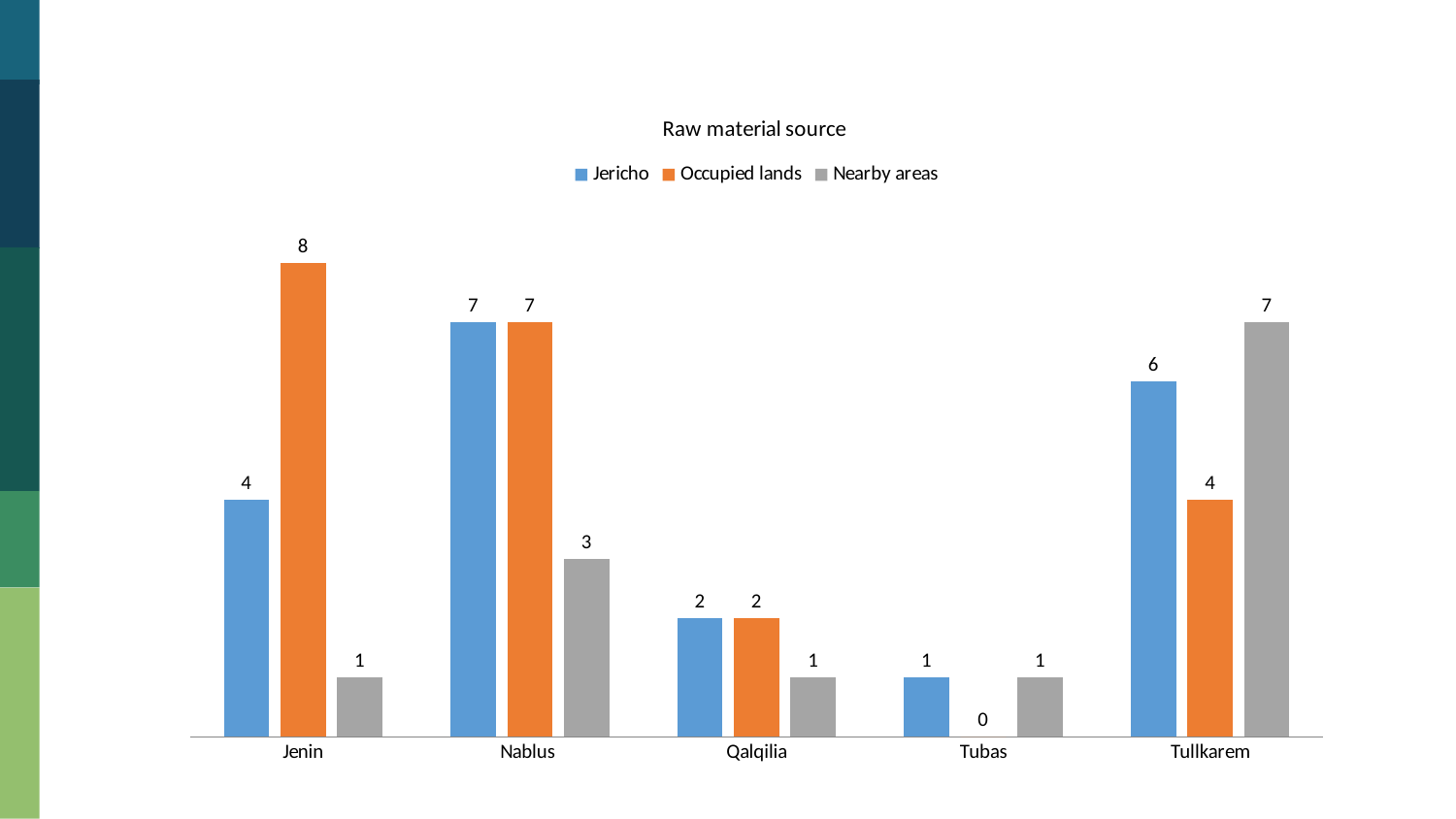
Which colour represents the Nearby areas series? Grey What kind of chart is shown on the slide? Bar chart What is the title of the chart? Raw material source What is the value for Nearby areas in Tullkarem? 7 How many series does the legend list? 3 What is the difference between the Occupied lands value and the Nearby areas value in Jenin? 7 Which category has the highest value for the Jericho series? Nablus Which is larger in Tullkarem: the Jericho value or the Occupied lands value? Jericho What is the value for Occupied lands in Jenin? 8 How many categories are shown on the x axis? 5 Which category has the lowest value for the Nearby areas series? Jenin, Qalqilia and Tubas (all 1) What is the value for Occupied lands in Tubas? 0